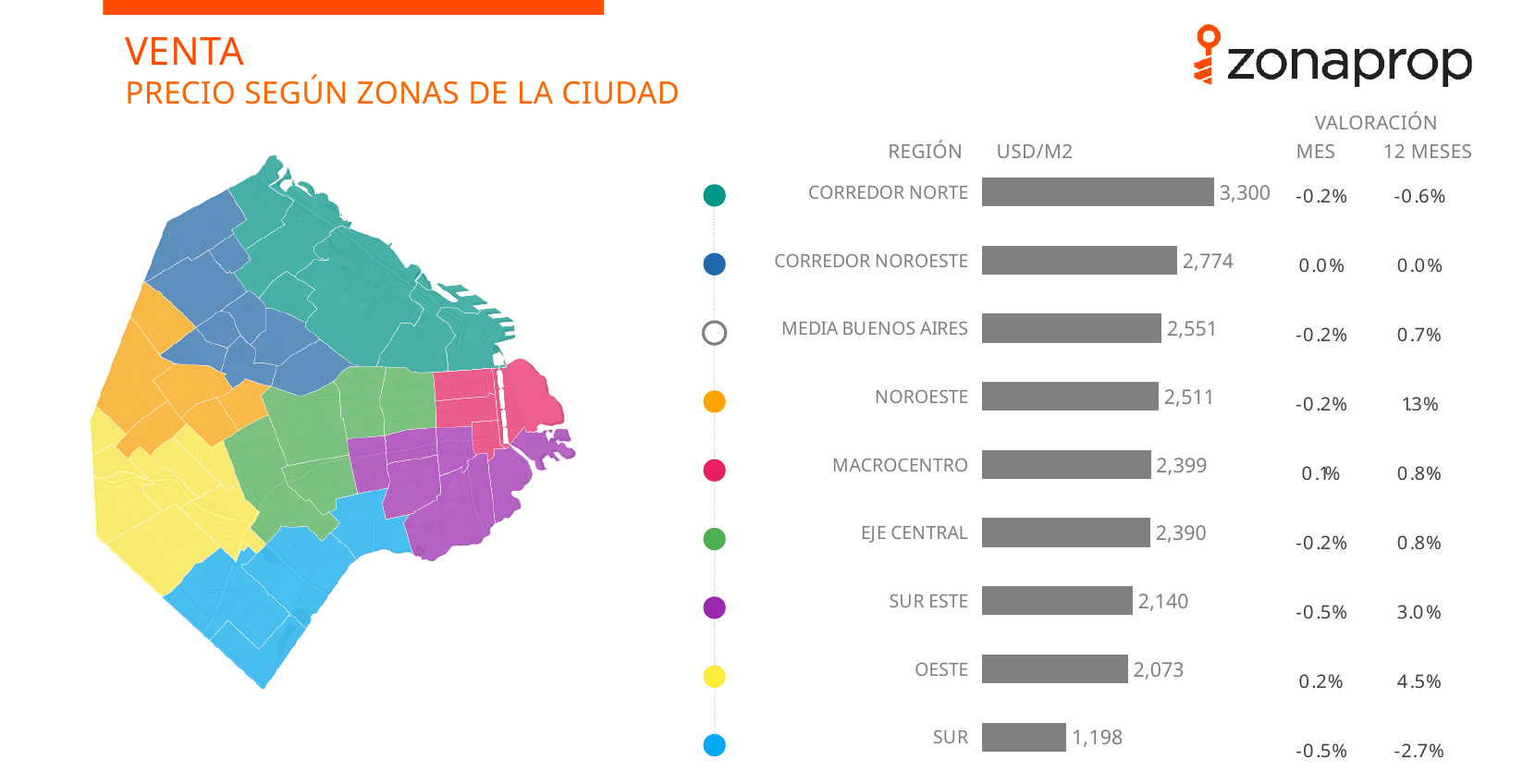
Which region has the highest USD/M2 value? CORREDOR NORTE What is the monthly valuation (VALORACIÓN MES) for SUR ESTE? -0.5% How many regions are shown in the bar chart? 9 What is the 12-month valuation (VALORACIÓN 12 MESES) for OESTE? 4.5% What is the difference in USD/M2 between CORREDOR NORTE and CORREDOR NOROESTE? 526 What kind of chart shows the USD/M2 prices by region? bar chart Which region has the lowest USD/M2 value? SUR What is the difference in USD/M2 between CORREDOR NORTE and SUR? 2,102 What is the USD/M2 value for SUR? 1,198 What is the USD/M2 value for MACROCENTRO? 2,399 Which has a higher USD/M2 value, SUR ESTE or OESTE? SUR ESTE What is the USD/M2 value for CORREDOR NORTE? 3,300